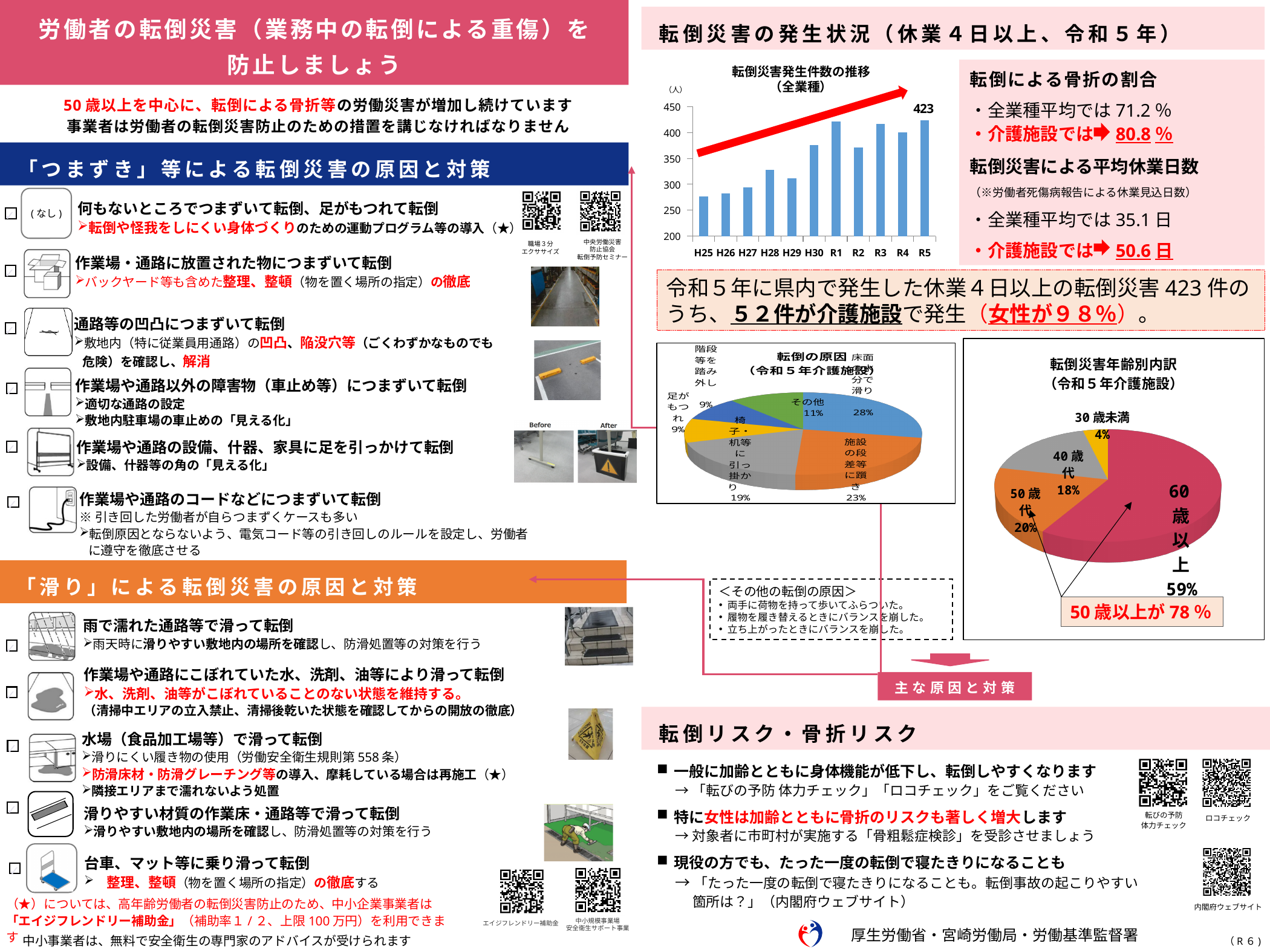
In the bar chart 転倒災害発生件数の推移（全業種）, is the value for R1 greater or less than 400? greater What kind of chart is 転倒災害発生件数の推移（全業種）? bar chart In the pie chart 転倒災害年齢別内訳（令和5年介護施設）, which age group has the smallest share? 30歳未満 In the bar chart 転倒災害発生件数の推移（全業種）, do the values generally rise or fall from H25 to R5? rise In the bar chart 転倒災害発生件数の推移（全業種）, how many years (bars) are shown? 11 In the pie chart 転倒の原因（令和5年介護施設）, what is the difference between 椅子・机等に引っ掛かり and その他? 8% In the pie chart 転倒の原因（令和5年介護施設）, which cause has the largest share? 床面の水分で滑り In the pie chart 転倒災害年齢別内訳（令和5年介護施設）, how many age groups are shown? 4 In the pie chart 転倒災害年齢別内訳（令和5年介護施設）, what share is 50歳代? 20% In the bar chart 転倒災害発生件数の推移（全業種）, what is the value for R5? 423 In the bar chart 転倒災害発生件数の推移（全業種）, is the value for H25 greater or less than 300? less In the pie chart 転倒の原因（令和5年介護施設）, what share is 施設の段差等に躓き? 23%